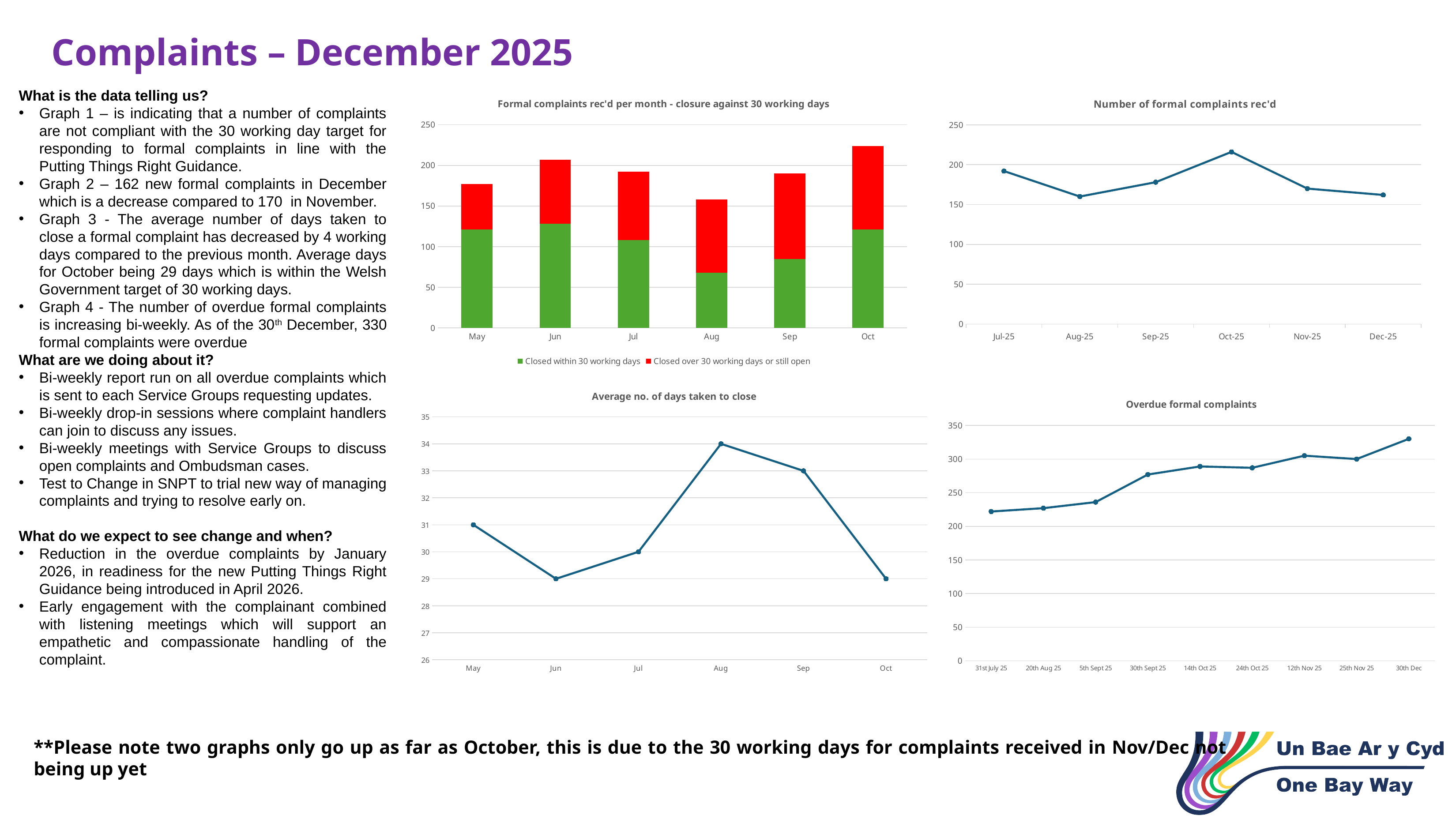
In the 'Average no. of days taken to close' chart, what is the value for Aug? 34 In the 'Overdue formal complaints' chart, is the value for 30th Dec greater or less than 300? greater How many months are plotted in the 'Number of formal complaints rec'd' chart? 6 In the 'Formal complaints rec'd per month - closure against 30 working days' chart, is the total bar for Oct greater or less than 200? greater In the 'Average no. of days taken to close' chart, what is the value for Jun? 29 What kind of chart is 'Formal complaints rec'd per month - closure against 30 working days'? bar chart In the 'Overdue formal complaints' chart, do the values generally rise or fall from 31st July 25 to 30th Dec? rise In the 'Average no. of days taken to close' chart, which is larger, the value for May or the value for Jul? May In the 'Formal complaints rec'd per month - closure against 30 working days' chart, which month has the tallest total bar? Oct In the 'Number of formal complaints rec'd' chart, which month has the highest point? Oct-25 How many series does the legend list in the 'Formal complaints rec'd per month - closure against 30 working days' chart? 2 In the 'Average no. of days taken to close' chart, what is the difference between the values for Aug and Sep? 1